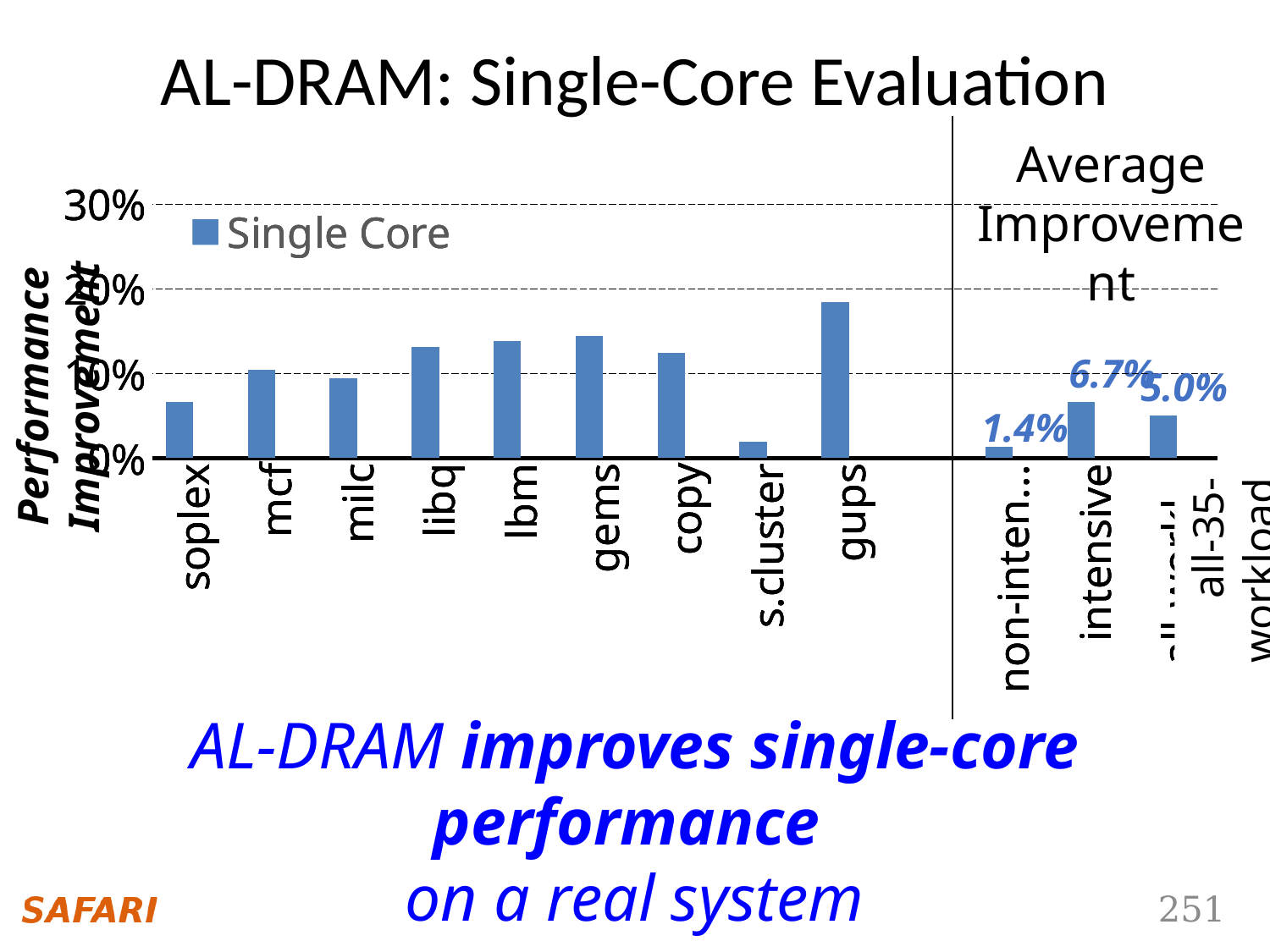
What is the average performance improvement across all 35 workloads? 5.0% How many series does the legend list? 1 What is the average performance improvement for the intensive workloads? 6.7% Which has a larger performance improvement, gups or lbm? gups Is the performance improvement for gups greater or less than 10%? greater What is the average performance improvement for the non-intensive workloads? 1.4% Which of the nine individual benchmarks (left of the divider) shows the lowest performance improvement? s.cluster What is the difference between the average improvement for intensive workloads and for non-intensive workloads? 5.3% How many individual benchmarks are plotted to the left of the vertical divider line? 9 Is the performance improvement for soplex greater or less than 10%? less Which individual benchmark shows the highest performance improvement? gups What kind of chart is shown on the slide? bar chart